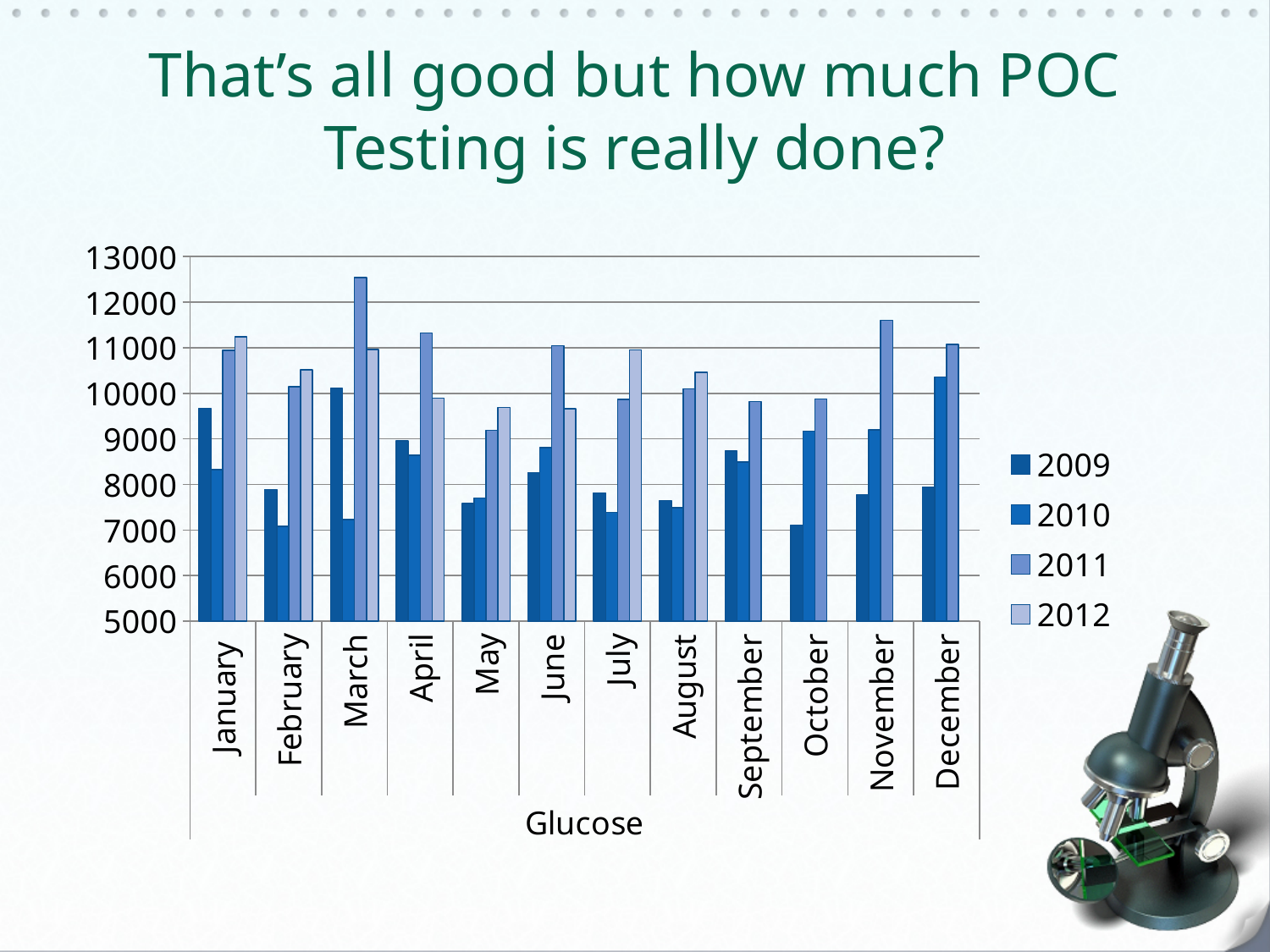
In April, which is larger: the 2011 value or the 2012 value? 2011 How many series does the legend list? 4 Is the 2011 value for November greater or less than 11000? greater In January, which is larger: the 2009 value or the 2010 value? 2009 In which month is the 2011 value highest? March Is the 2010 value for February greater or less than 8000? less In June, which is larger: the 2009 value or the 2010 value? 2010 Is the 2011 value for March greater or less than 12000? greater What label appears below the month names on the x axis? Glucose What kind of chart is shown on the slide? Bar chart How many months are shown along the x axis? 12